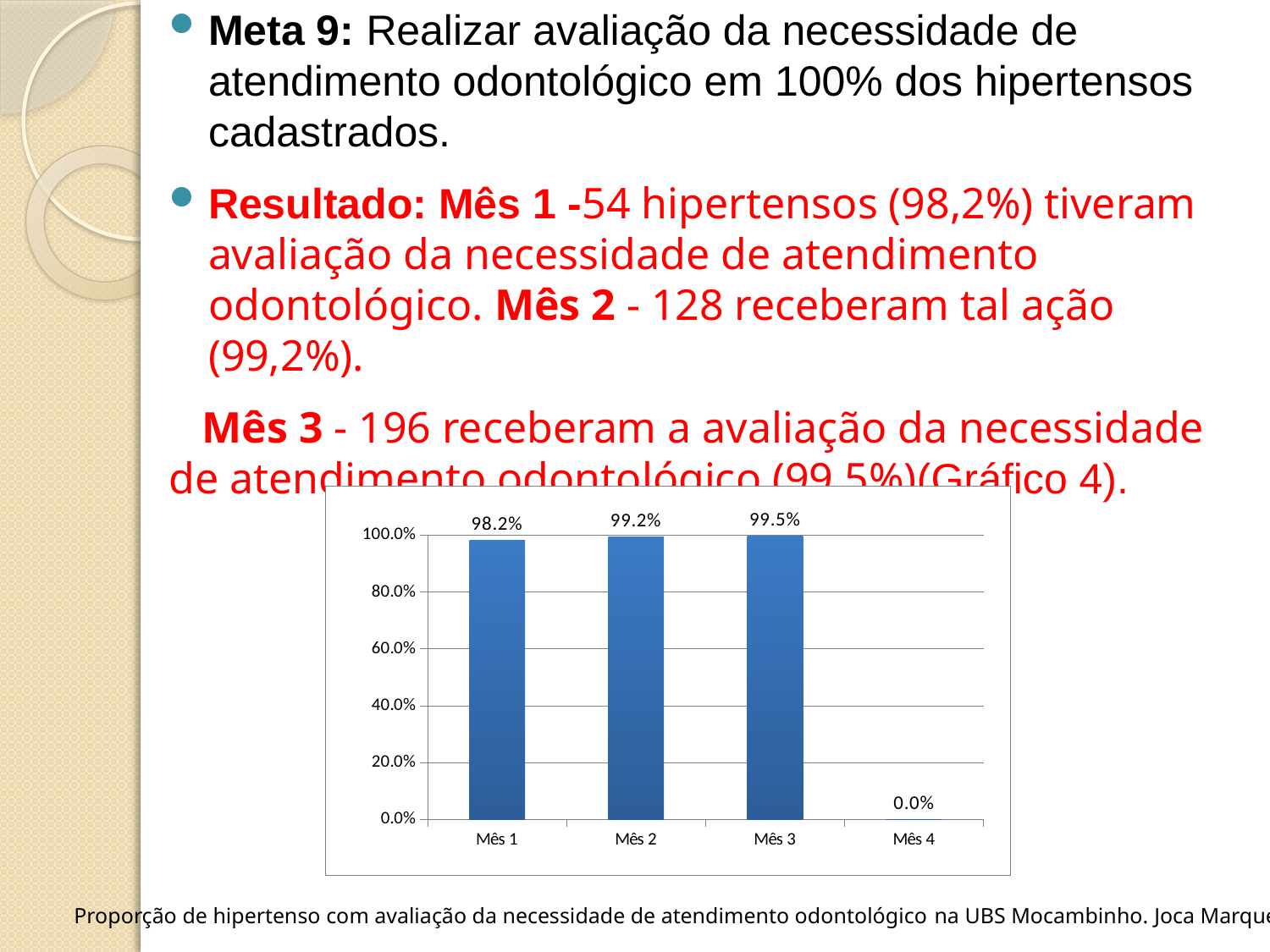
What is the value for Mês 3? 99.5% How many categories are shown on the x axis? 4 What is the value for Mês 4? 0.0% Which month has the highest value? Mês 3 What is the difference between the values for Mês 2 and Mês 1? 1.0% What kind of chart is shown on the slide? bar chart What is the value for Mês 2? 99.2% Which month has the lowest value? Mês 4 What is the difference between the values for Mês 3 and Mês 1? 1.3% Is the value for Mês 2 greater or less than 80.0%? greater Which is larger, the value for Mês 1 or the value for Mês 3? Mês 3 What is the value for Mês 1? 98.2%